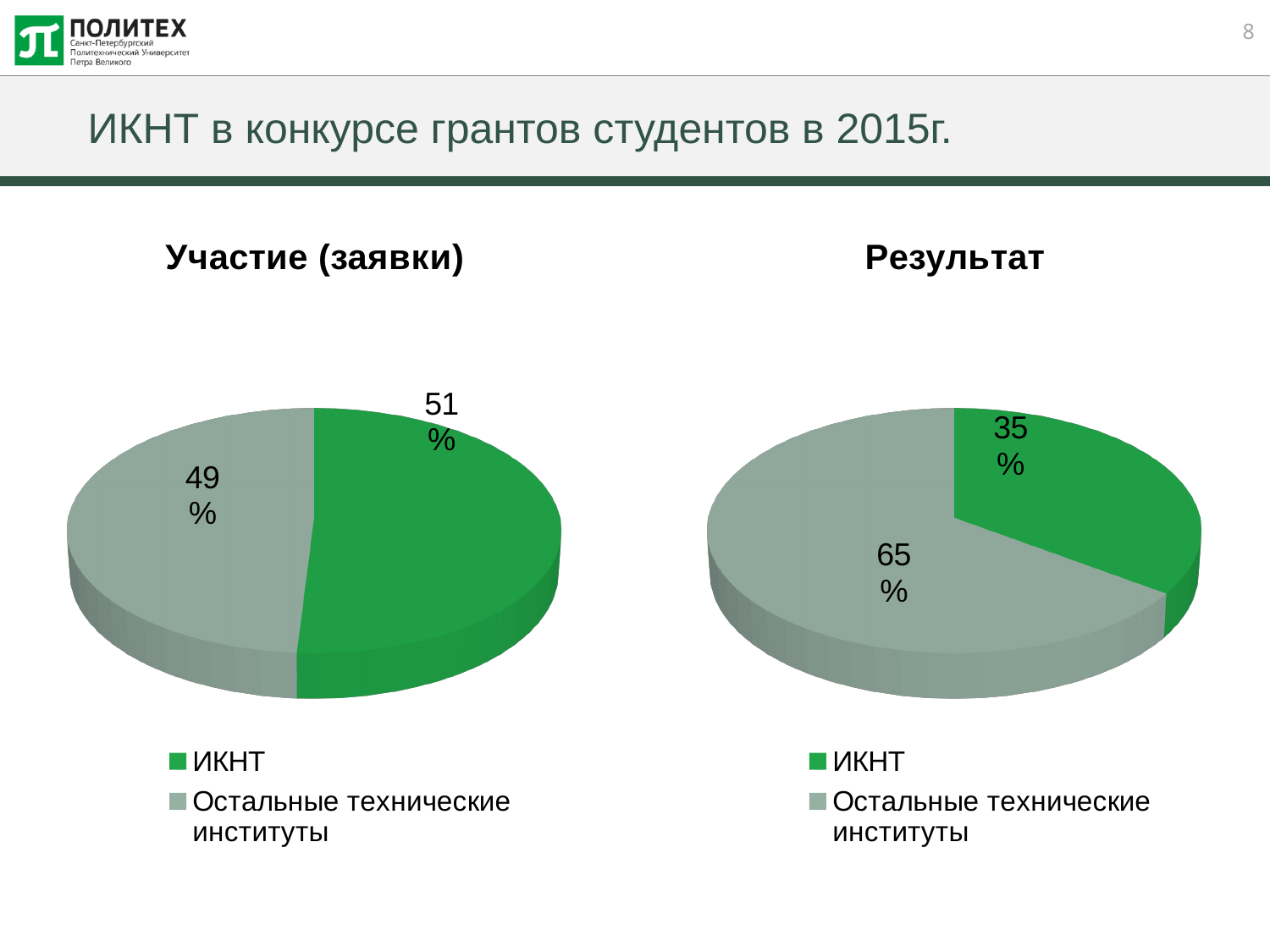
In the "Результат" chart, which is larger: the share of ИКНТ or the share of Остальные технические институты? Остальные технические институты In the "Результат" chart, which category has the smallest slice? ИКНТ In the "Участие (заявки)" chart, what share does ИКНТ have? 51% In the "Участие (заявки)" chart, what is the difference between the shares of ИКНТ and Остальные технические институты? 2% In the "Результат" chart, which category has the largest slice? Остальные технические институты In the "Результат" chart, what share does ИКНТ have? 35% In the "Результат" chart, what is the difference between the shares of Остальные технические институты and ИКНТ? 30% In the "Участие (заявки)" chart, what share do Остальные технические институты have? 49% In the "Результат" chart, what share do Остальные технические институты have? 65% How many slices does the "Результат" chart have? 2 In the "Участие (заявки)" chart, what colour is the ИКНТ slice? Green What kind of chart is the "Участие (заявки)" chart? Pie chart